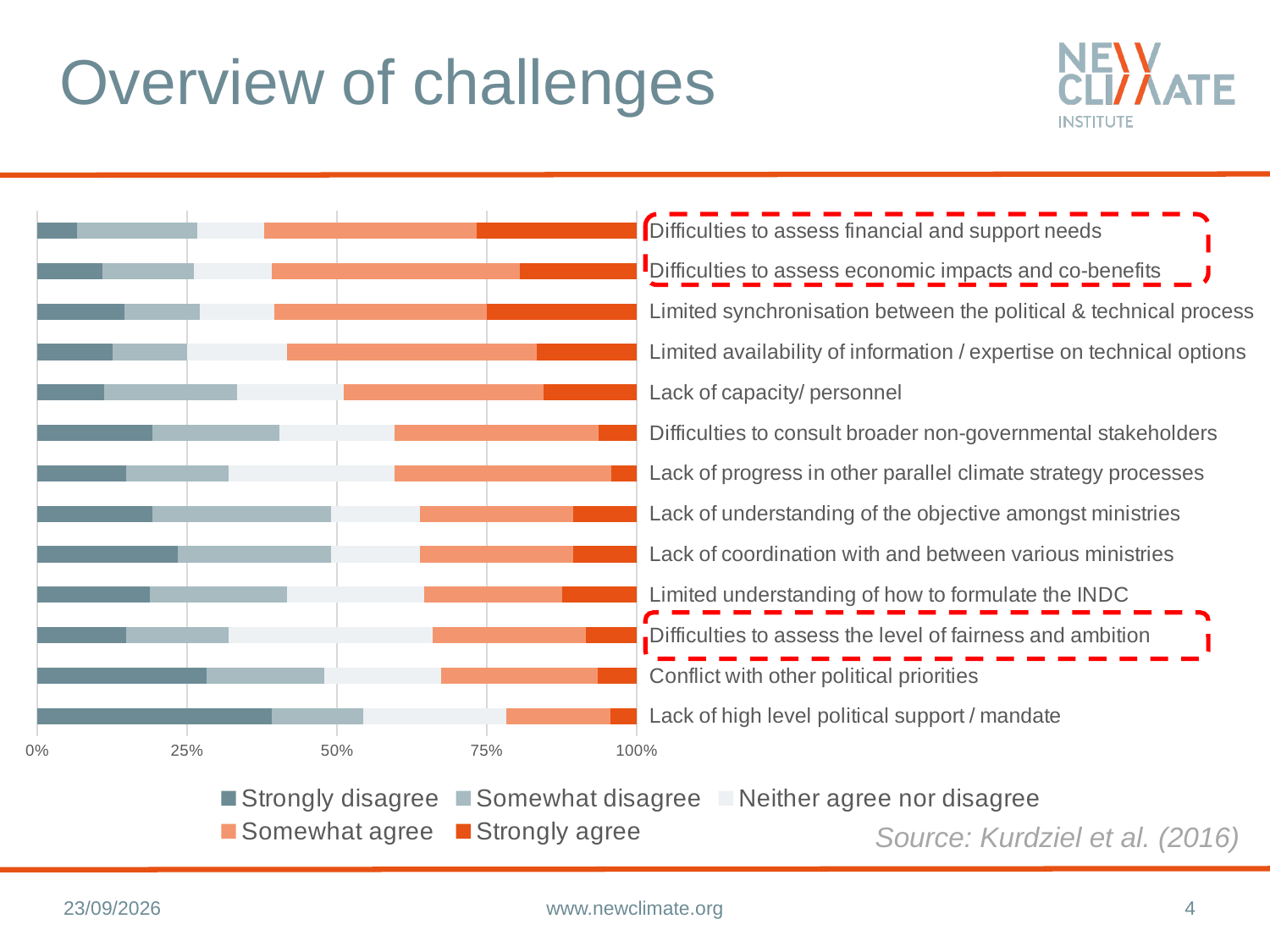
Is the 'Strongly disagree' value for 'Lack of high level political support / mandate' greater or less than 25%? greater Which legend entry is shown in the darkest orange colour? Strongly agree What kind of chart is shown on the slide? Stacked bar chart How many series does the legend list? 5 Which category has the largest 'Strongly disagree' segment? Lack of high level political support / mandate Is the 'Strongly disagree' value for 'Difficulties to assess financial and support needs' greater or less than 25%? less What is the total of the stacked bar for 'Lack of capacity/ personnel'? 100% Which category has the smallest 'Strongly disagree' segment? Difficulties to assess financial and support needs How many challenge categories are plotted in the chart? 13 Which has the larger 'Strongly disagree' segment: 'Conflict with other political priorities' or 'Lack of capacity/ personnel'? Conflict with other political priorities What source is cited for the chart? Kurdziel et al. (2016) Is the 'Somewhat agree' value for 'Difficulties to assess financial and support needs' greater or less than 25%? greater